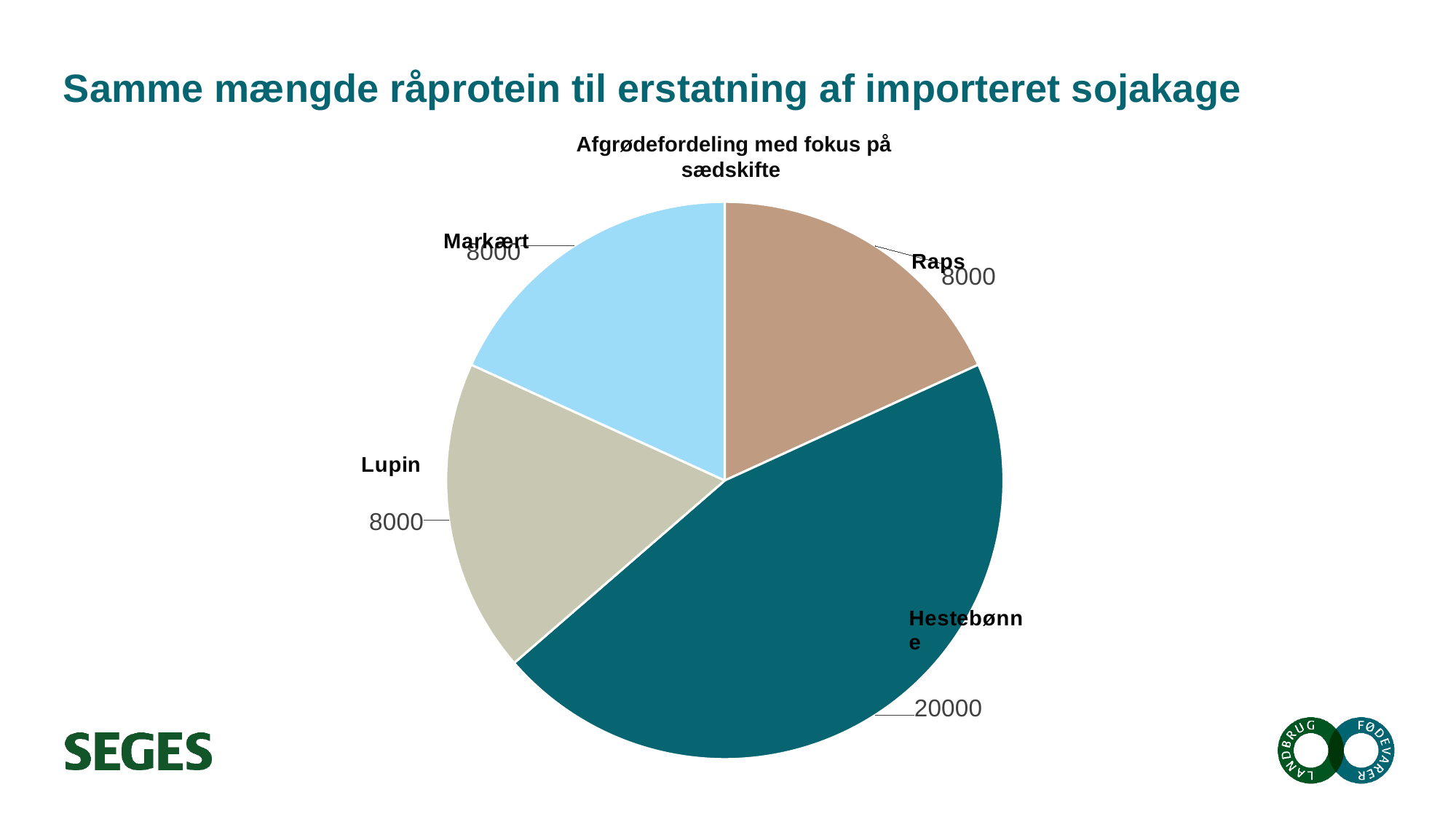
What is the value for Raps? 8000 What is the total of all slices in the pie chart? 44000 What colour is the Hestebønne slice? dark teal What kind of chart is shown on the slide? pie chart Which is larger, the value for Hestebønne or the value for Lupin? Hestebønne How many slices does the pie chart have? 4 What is the value for Hestebønne? 20000 What is the value for Lupin? 8000 What is the title of the pie chart? Afgrødefordeling med fokus på sædskifte Which category has the largest slice of the pie? Hestebønne What is the value for Markært? 8000 What is the difference between the value for Hestebønne and the value for Raps? 12000